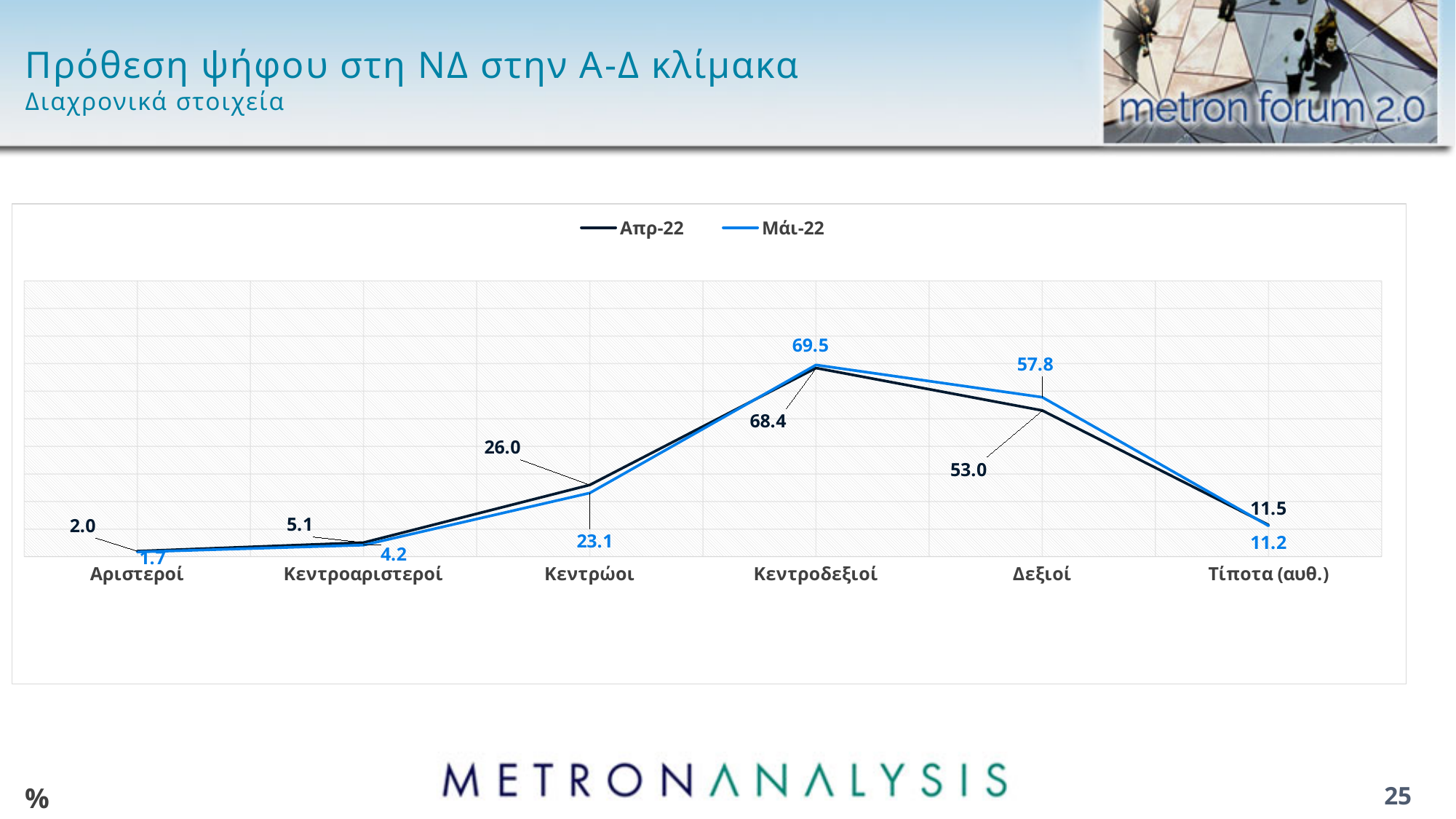
Which category has the lowest Απρ-22 value? Αριστεροί For Κεντρώοι, which series has the larger value, Απρ-22 or Μάι-22? Απρ-22 What is the Μάι-22 value for Δεξιοί? 57.8 What is the Απρ-22 value for Κεντρώοι? 26.0 What is the Απρ-22 value for Τίποτα (αυθ.)? 11.5 What kind of chart is shown on the slide? Line chart What is the Μάι-22 value for Αριστεροί? 1.7 How many categories are shown on the x axis? 6 What is the difference between the Μάι-22 and Απρ-22 values for Δεξιοί? 4.8 How many series does the legend list? 2 Which category has the highest Μάι-22 value? Κεντροδεξιοί What colour is the line for the Μάι-22 series? Blue